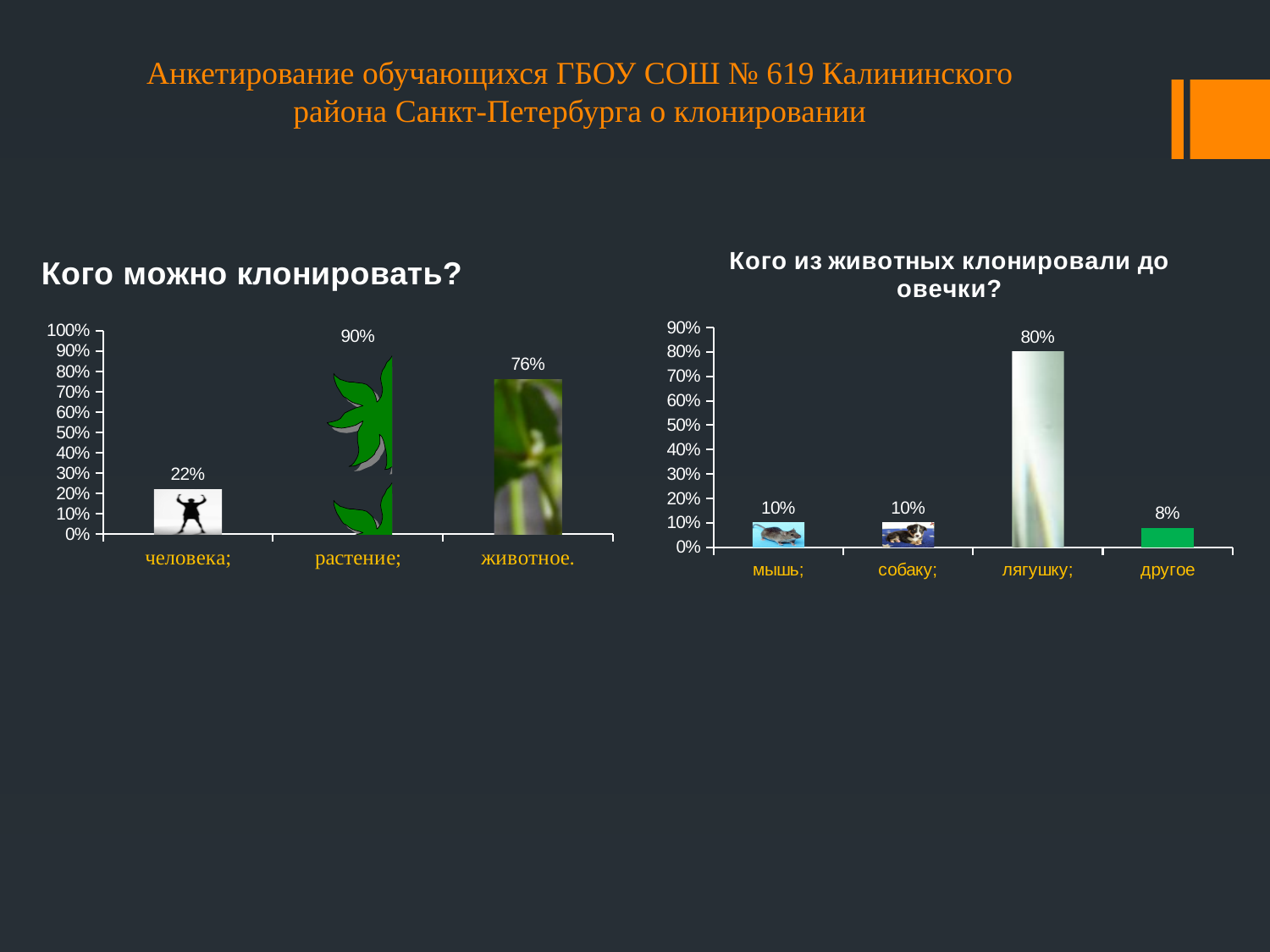
In the chart 'Кого из животных клонировали до овечки?', which category has the highest value? лягушку In the chart 'Кого можно клонировать?', how many categories are shown? 3 What kind of chart is 'Кого из животных клонировали до овечки?'? bar chart In the chart 'Кого можно клонировать?', what is the difference between the values for растение and животное? 14% In the chart 'Кого из животных клонировали до овечки?', how many categories are shown? 4 In the chart 'Кого можно клонировать?', what is the value for человека? 22% In the chart 'Кого из животных клонировали до овечки?', what is the value for лягушку? 80% In the chart 'Кого можно клонировать?', which category has the lowest value? человека In the chart 'Кого из животных клонировали до овечки?', what is the difference between the values for лягушку and собаку? 70% In the chart 'Кого из животных клонировали до овечки?', which is larger, the value for мышь or the value for другое? мышь In the chart 'Кого из животных клонировали до овечки?', what is the value for другое? 8% In the chart 'Кого можно клонировать?', what is the value for растение? 90%